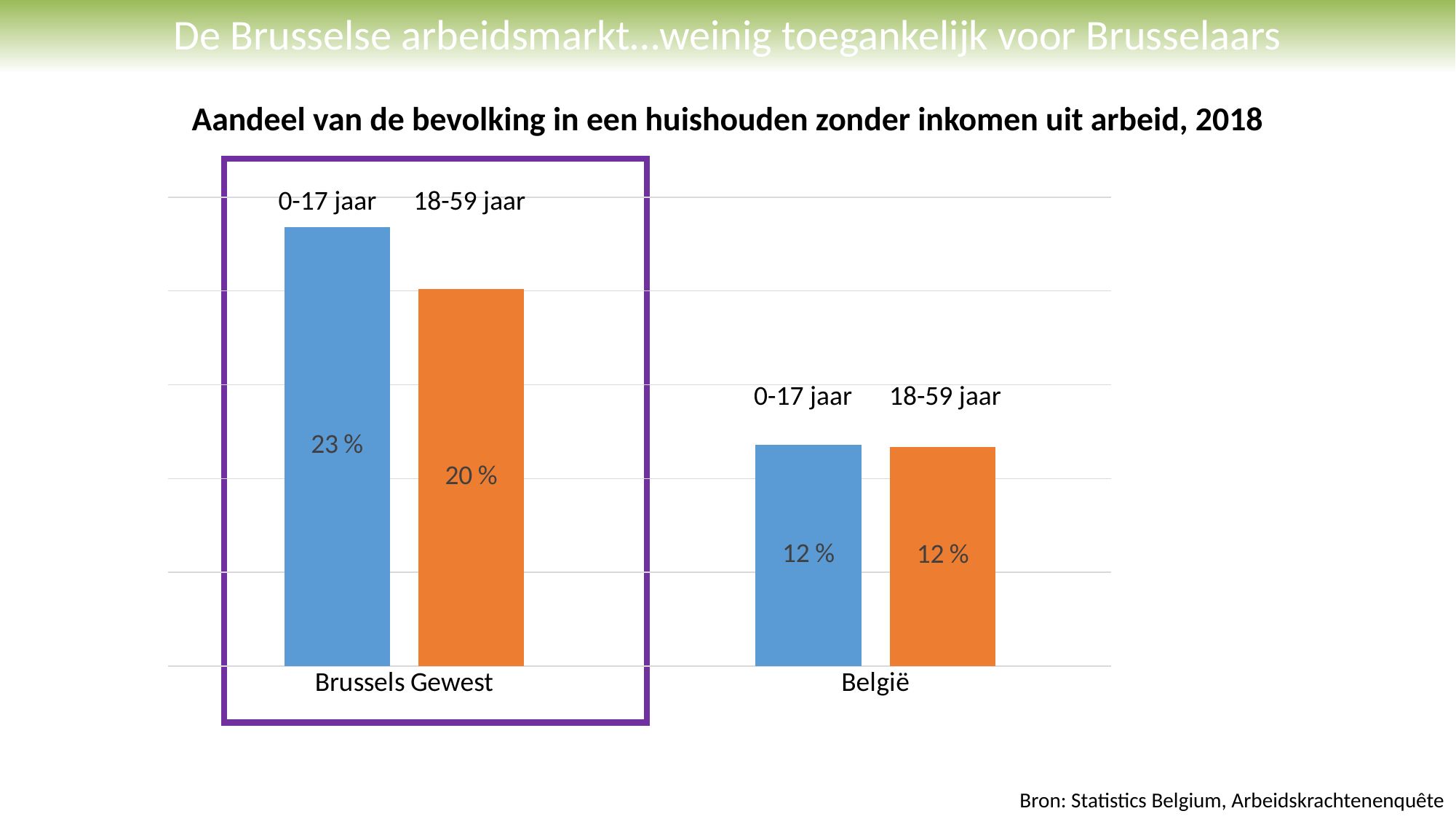
Which is larger: the 18-59 jaar value for Brussels Gewest or for België? Brussels Gewest What is the value for the 18-59 jaar group in België? 12 % What is the title of the chart? Aandeel van de bevolking in een huishouden zonder inkomen uit arbeid, 2018 What is the value for the 18-59 jaar group in Brussels Gewest? 20 % What is the value for the 0-17 jaar group in België? 12 % How many age groups are plotted for each region? 2 What is the difference between the 0-17 jaar values for Brussels Gewest and België? 11 % What is the difference between the 0-17 jaar and 18-59 jaar values in Brussels Gewest? 3 % Which bar has the highest value on the chart? 0-17 jaar, Brussels Gewest What kind of chart is shown on the slide? bar chart How many regions are shown on the x axis of the chart? 2 What is the value for the 0-17 jaar group in Brussels Gewest? 23 %